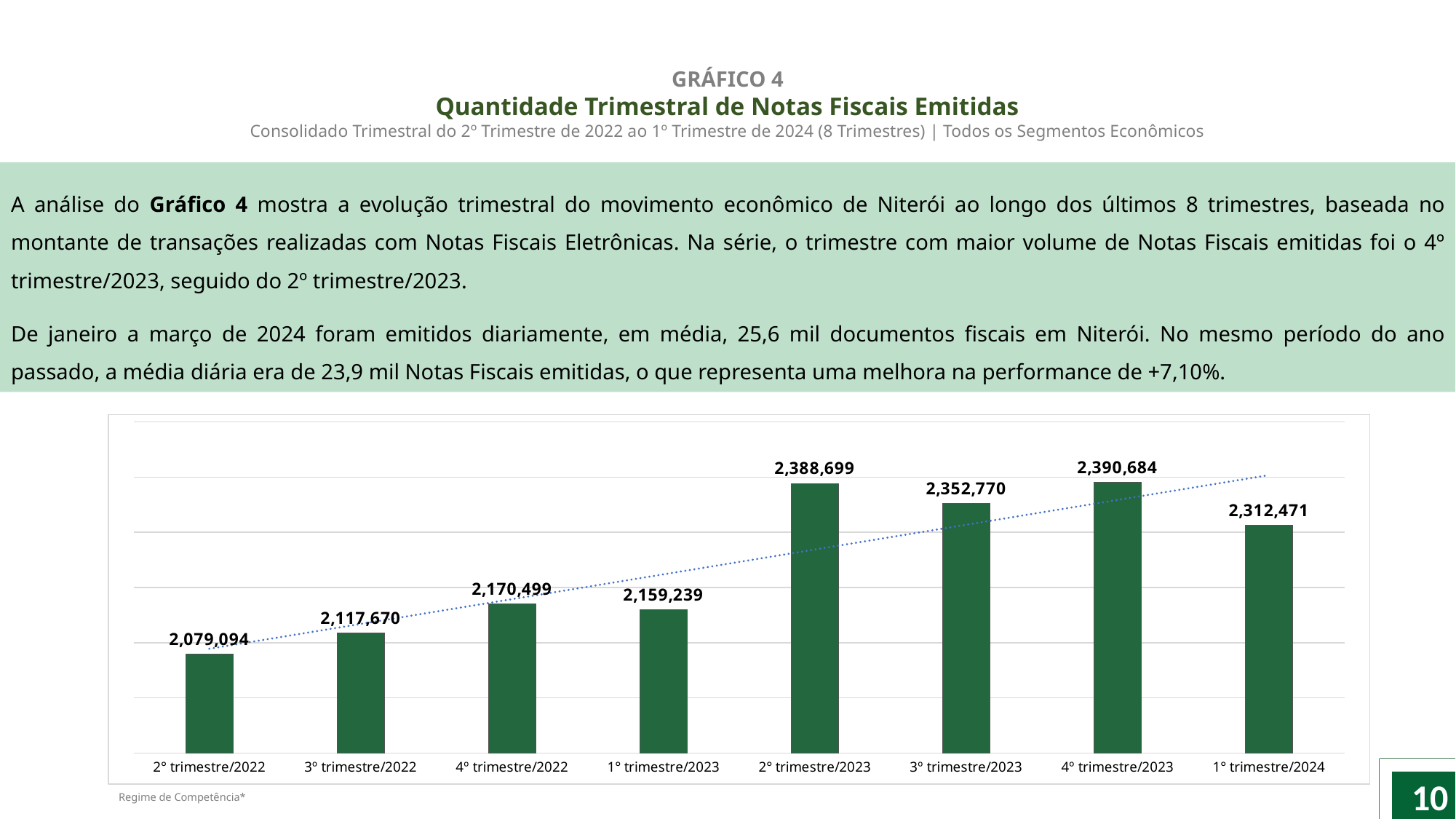
What is the difference between the values for 4º trimestre/2022 and 3º trimestre/2022? 52,829 How many quarters are shown on the chart? 8 What is the title of the chart? Quantidade Trimestral de Notas Fiscais Emitidas Which quarter has the highest value? 4º trimestre/2023 Which quarter has the lowest value? 2º trimestre/2022 What is the difference between the values for 4º trimestre/2023 and 2º trimestre/2022? 311,590 What is the value for 1º trimestre/2024? 2,312,471 What is the value for 3º trimestre/2023? 2,352,770 What is the value for 4º trimestre/2023? 2,390,684 What is the value for 2º trimestre/2022? 2,079,094 What kind of chart is shown on the slide? Bar chart Which is larger, the value for 2º trimestre/2023 or the value for 1º trimestre/2024? 2º trimestre/2023